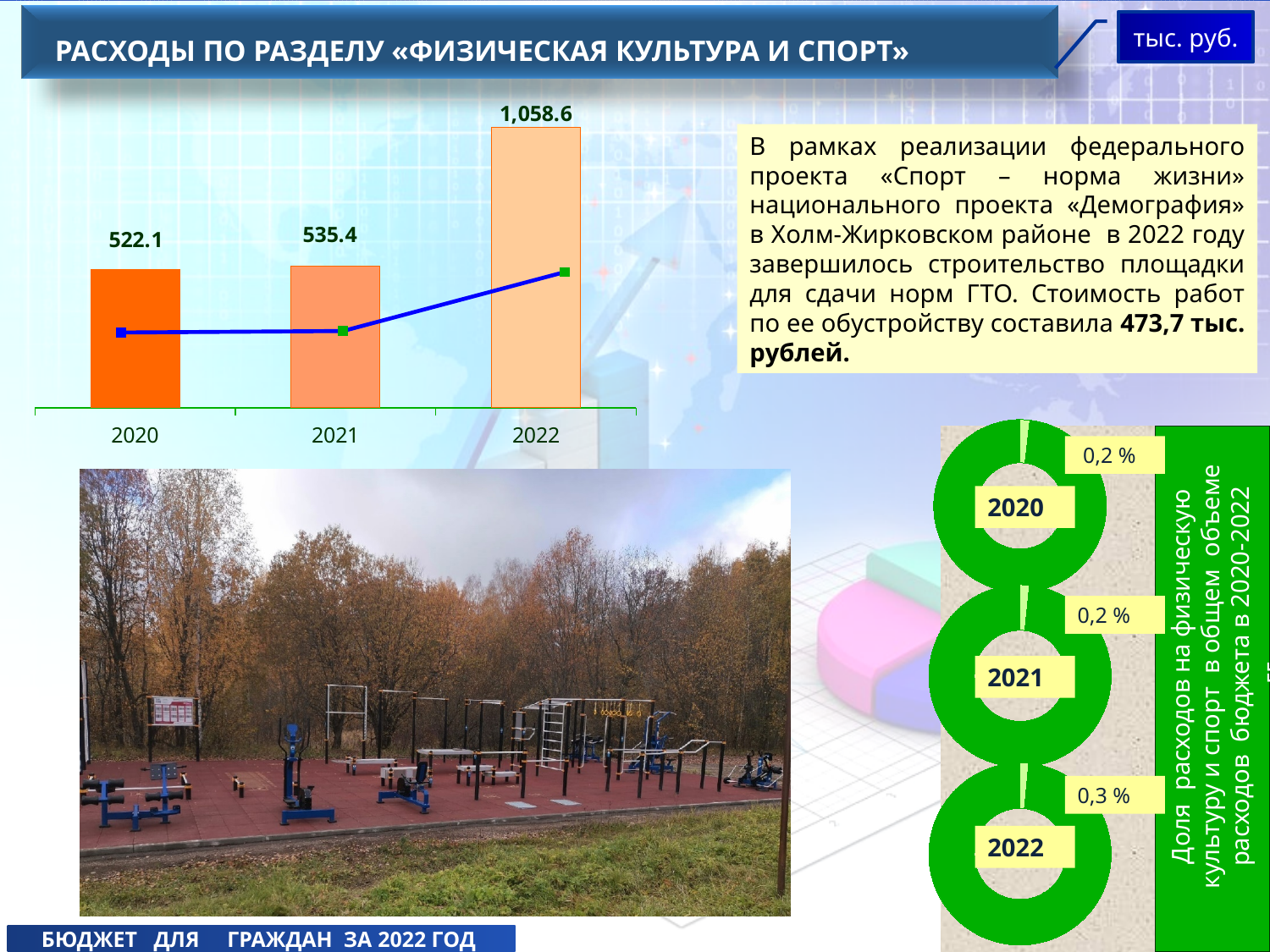
Which is larger on the bar chart, the value for 2020 or the value for 2021? 2021 What is the value for 2021 on the bar chart? 535.4 Do the values on the bar chart rise or fall from 2020 to 2022? rise What is the difference between the values for 2021 and 2020 on the bar chart? 13.3 In what units are the values on the bar chart given? тыс. руб. What kind of chart is used to show the expenditures by year? bar chart Which year has the lowest value on the bar chart? 2020 What is the value for 2022 on the bar chart? 1,058.6 What is the difference between the values for 2022 and 2021 on the bar chart? 523.2 What is the value for 2020 on the bar chart? 522.1 Which year has the highest value on the bar chart? 2022 How many years are shown on the bar chart? 3